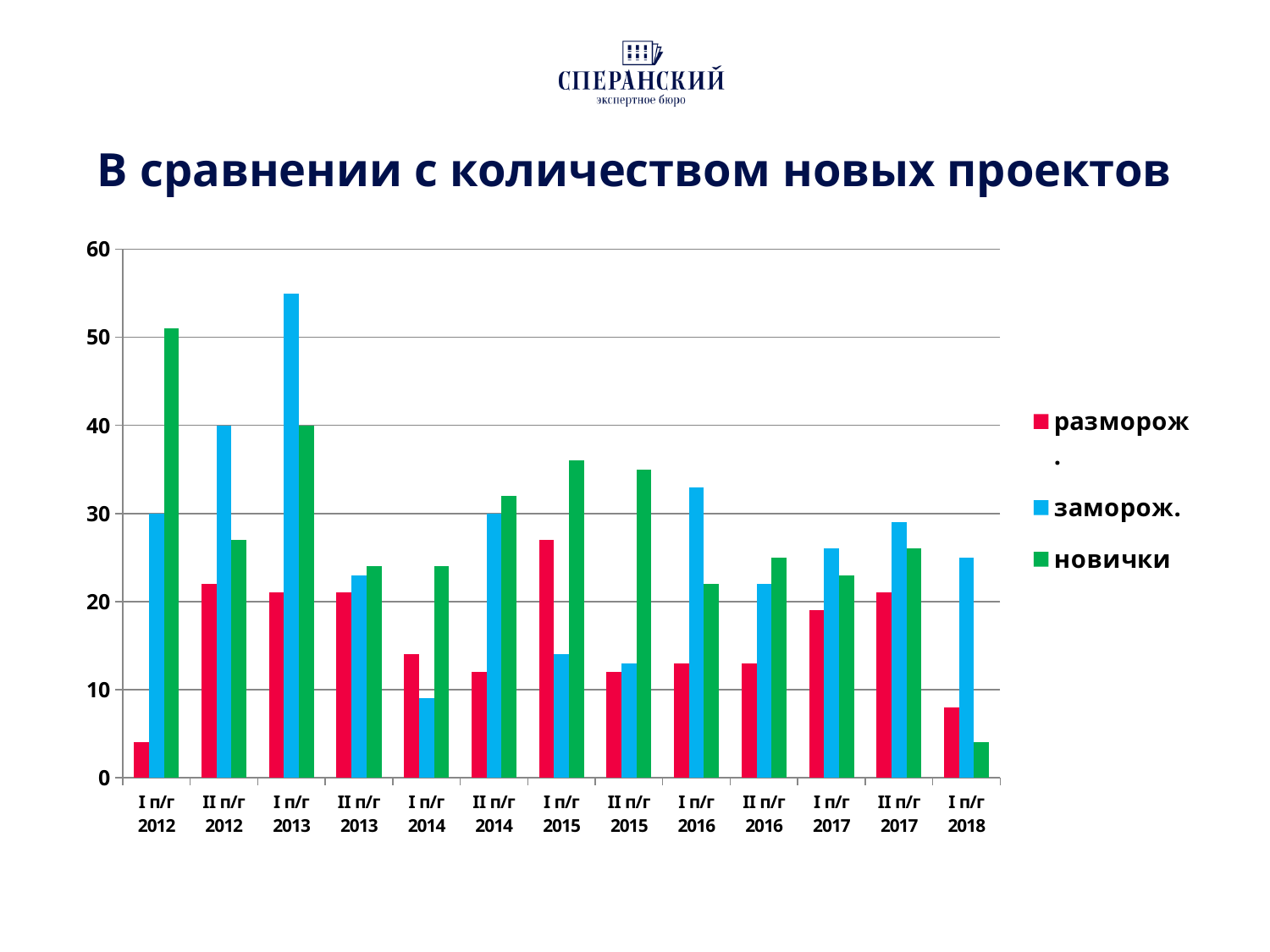
In which period is the value for заморож. the highest? I п/г 2013 How many series does the legend list? 3 What kind of chart is shown on the slide? bar chart Is the value for заморож. in I п/г 2013 greater or less than 50? greater In which period is the value for разморож. the lowest? I п/г 2012 Is the value for разморож. in I п/г 2015 greater or less than 20? greater What are the three series listed in the legend? разморож., заморож., новички In I п/г 2015, which is larger: разморож. or заморож.? разморож. In which period is the value for новички the highest? I п/г 2012 How many periods (categories) are shown on the x axis? 13 Is the value for новички in I п/г 2018 greater or less than 10? less In I п/г 2012, which is larger: новички or заморож.? новички